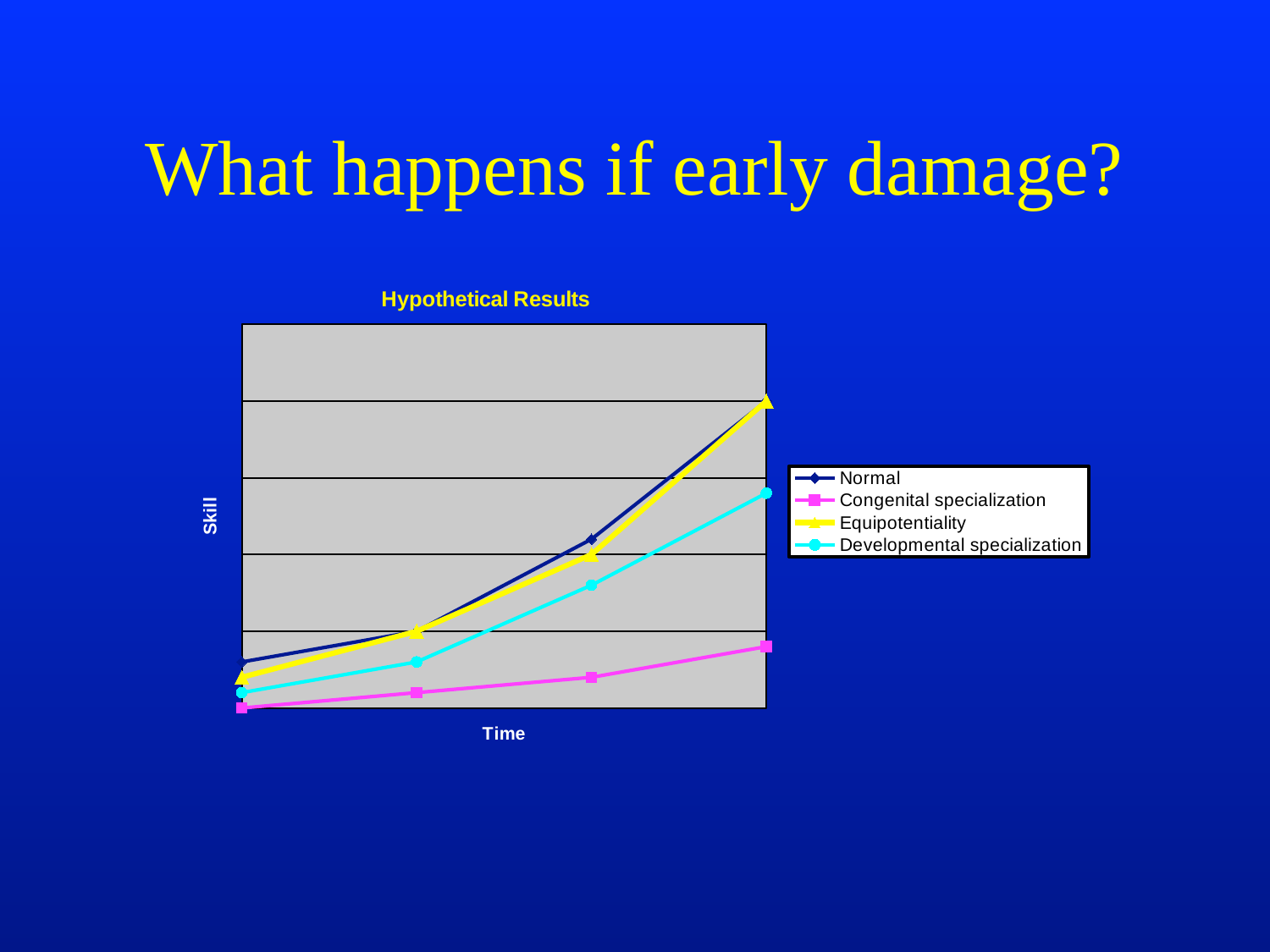
At the second time point, which is higher: Equipotentiality or Developmental specialization? Equipotentiality What is the label on the vertical axis of the chart? Skill At the final time point, which is higher: Developmental specialization or Congenital specialization? Developmental specialization How many series does the legend list? 4 What is the title of the chart? Hypothetical Results Does the Congenital specialization series rise or fall along the Time axis? Rises What kind of chart is shown on the slide? Line chart Which series has the lowest Skill at the first time point? Congenital specialization Which series has the lowest Skill at the final time point? Congenital specialization At the final time point, which is higher: Normal or Developmental specialization? Normal How many data points are plotted for the Normal series? 4 Does the Normal series rise or fall as Time increases? Rises